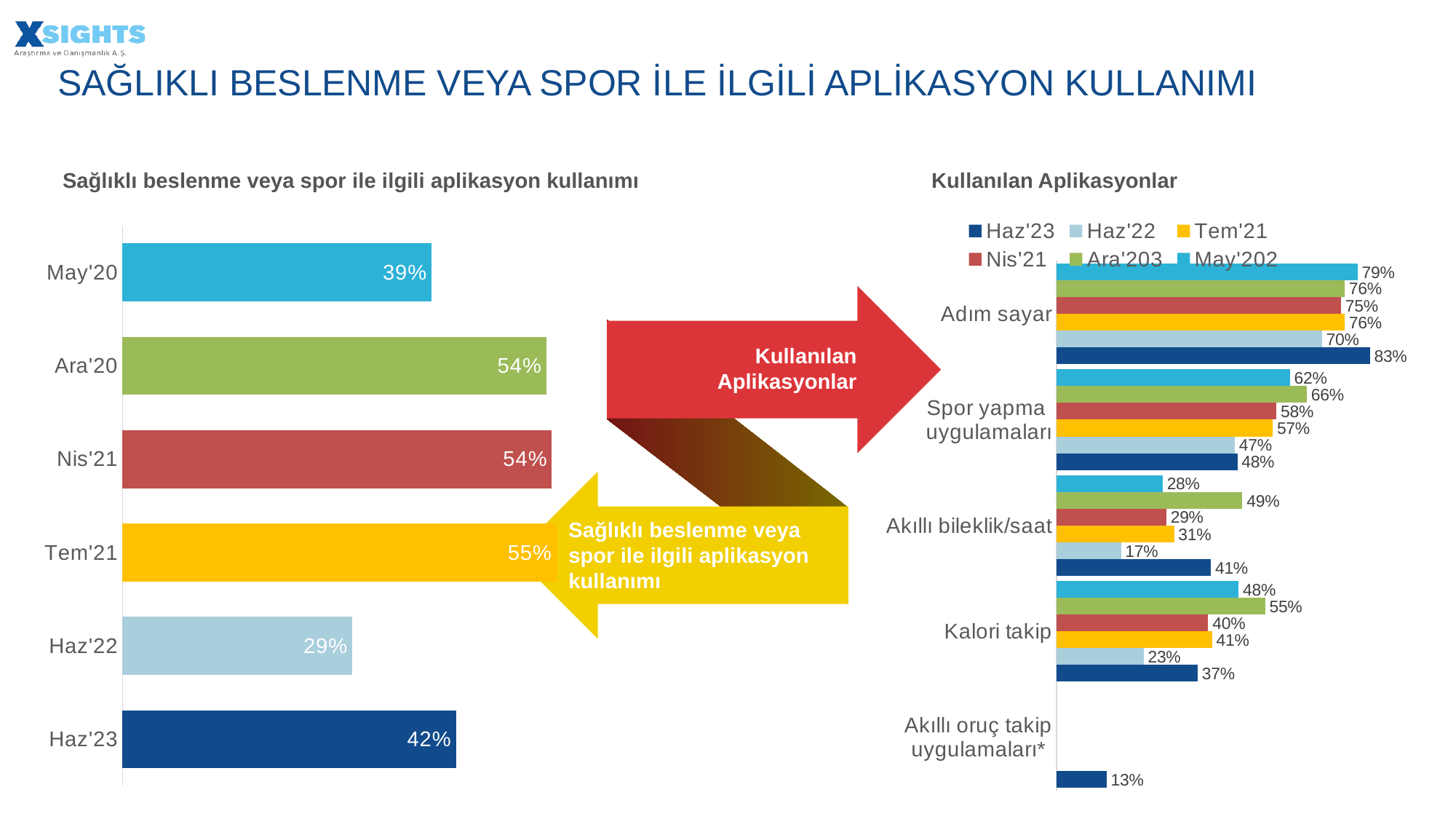
How many series does the legend of the right chart 'Kullanılan Aplikasyonlar' list? 6 What type of chart is the left chart 'Sağlıklı beslenme veya spor ile ilgili aplikasyon kullanımı'? Bar chart In the left chart 'Sağlıklı beslenme veya spor ile ilgili aplikasyon kullanımı', which period has the lowest value? Haz'22 In the right chart 'Kullanılan Aplikasyonlar', what is the Haz'22 value for Akıllı bileklik/saat? 17% In the left chart 'Sağlıklı beslenme veya spor ile ilgili aplikasyon kullanımı', which period has the highest value? Tem'21 In the right chart 'Kullanılan Aplikasyonlar', what is the Haz'23 value for Akıllı oruç takip uygulamaları*? 13% How many periods are shown in the left chart 'Sağlıklı beslenme veya spor ile ilgili aplikasyon kullanımı'? 6 In the right chart 'Kullanılan Aplikasyonlar', what is the difference between the Haz'23 and Haz'22 values for Spor yapma uygulamaları? 1 percentage point In the left chart 'Sağlıklı beslenme veya spor ile ilgili aplikasyon kullanımı', what is the difference between the values for Haz'23 and Haz'22? 13 percentage points In the right chart 'Kullanılan Aplikasyonlar', what is the Haz'23 value for Adım sayar? 83% In the left chart 'Sağlıklı beslenme veya spor ile ilgili aplikasyon kullanımı', what is the value for Haz'23? 42% In the right chart 'Kullanılan Aplikasyonlar', which is larger for Kalori takip: the Haz'23 value or the Haz'22 value? Haz'23